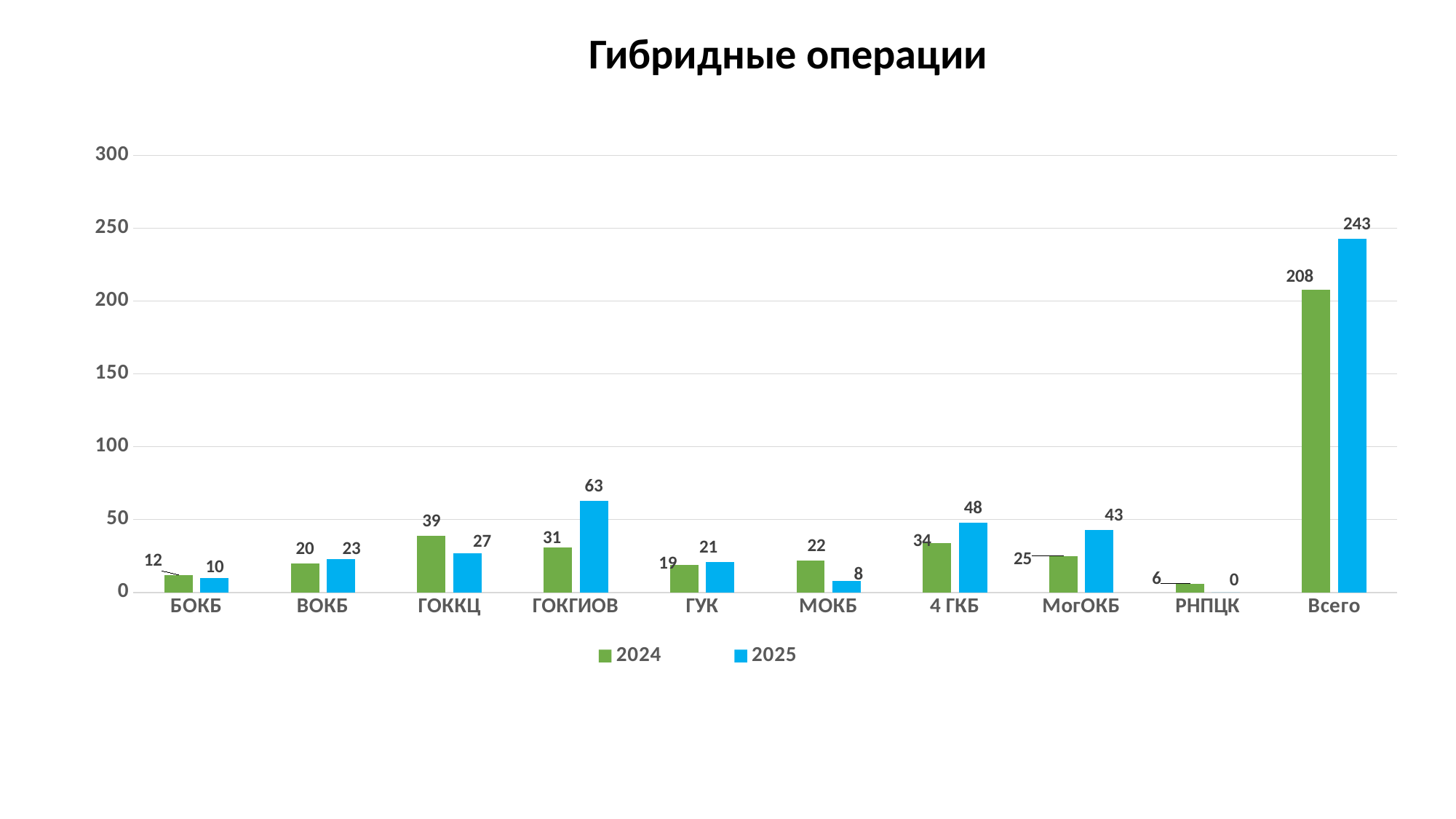
What is the difference between the 2025 and 2024 values for Всего? 35 Is the 2024 value for Всего greater or less than 200? greater What is the 2024 value for МогОКБ? 25 What is the 2025 value for Всего? 243 What is the 2025 value for ГОКГИОВ? 63 Which is larger for МОКБ, the 2024 value or the 2025 value? 2024 What type of chart is shown? bar chart How many categories are shown on the x axis? 10 Which category has the lowest 2025 value? РНПЦК How many series does the legend list? 2 What is the difference between the 2024 and 2025 values for ГОККЦ? 12 Excluding Всего, which category has the highest 2025 value? ГОКГИОВ